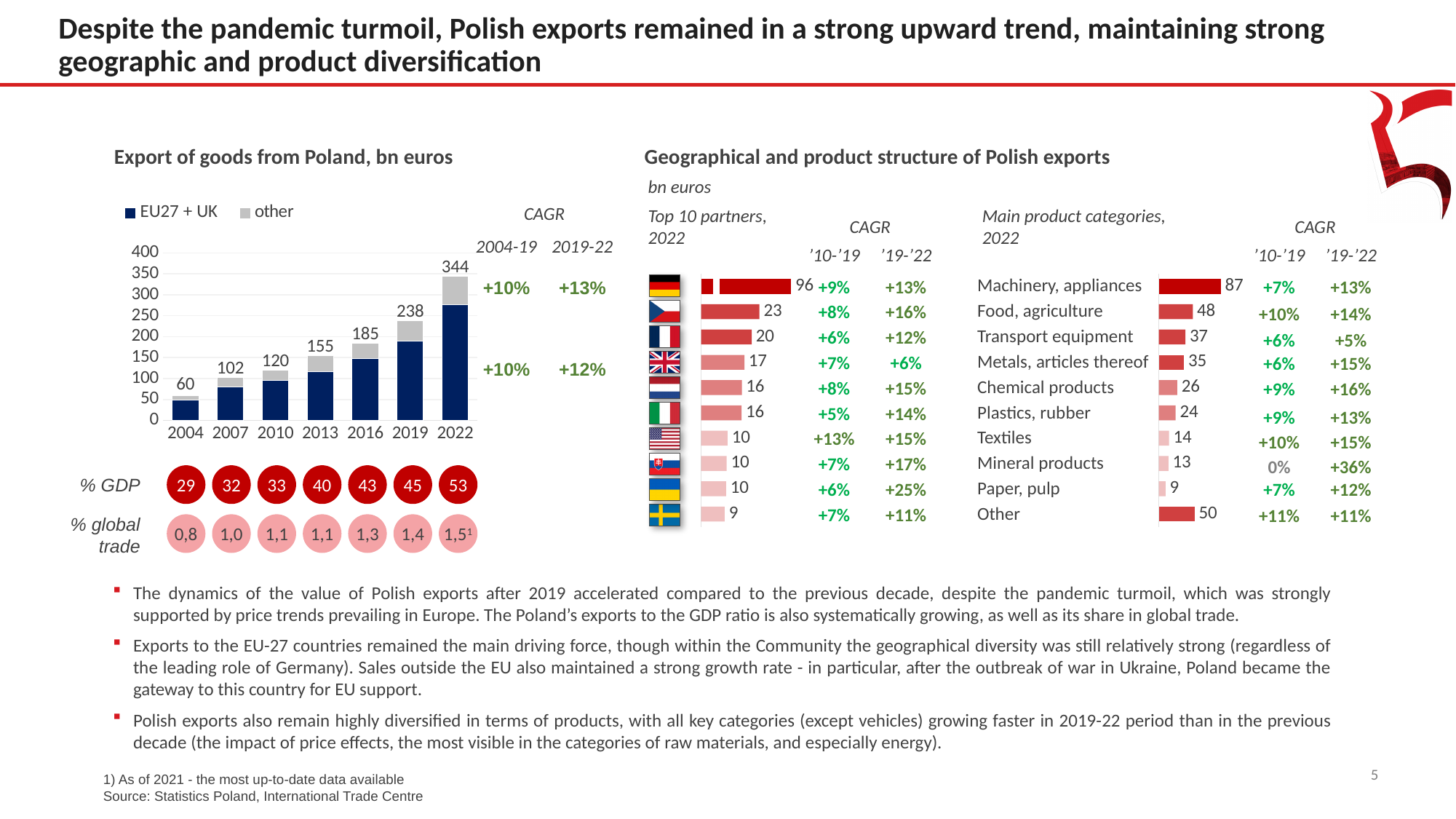
In the 'Main product categories, 2022' chart, which product category has the lowest value? Paper, pulp In the 'Main product categories, 2022' chart, which named product category (excluding Other) has the highest value? Machinery, appliances In the 'Main product categories, 2022' chart, what is the difference between Machinery, appliances and Food, agriculture? 39 In the 'Export of goods from Poland, bn euros' chart, by how much did total exports increase from 2019 to 2022? 106 In the 'Export of goods from Poland, bn euros' chart, what was the total export value in 2004? 60 In the 'Export of goods from Poland, bn euros' chart, is the EU27 + UK value for 2022 greater or less than 250? greater In the 'Main product categories, 2022' chart, what is the value for Food, agriculture? 48 What kind of chart is 'Export of goods from Poland, bn euros'? stacked bar chart In the 'Export of goods from Poland, bn euros' chart, how many years are shown on the x axis? 7 In the 'Export of goods from Poland, bn euros' chart, what was the total export value in 2022? 344 In the 'Export of goods from Poland, bn euros' chart, do total exports rise or fall from 2004 to 2022? rise In the 'Export of goods from Poland, bn euros' chart, how many series does the legend list? 2